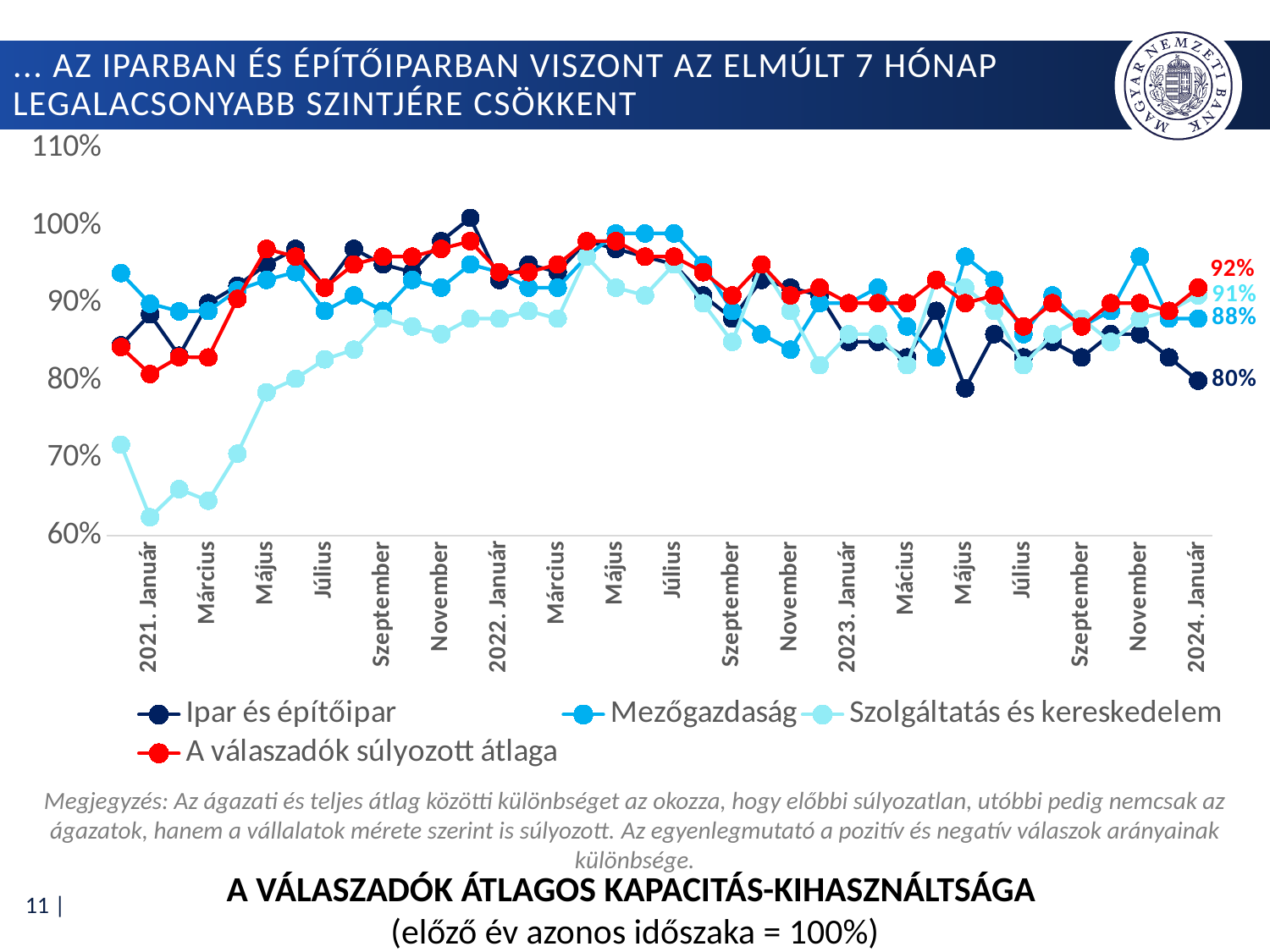
Is the value for Szolgáltatás és kereskedelem in 2021. Január greater or less than 80%? less What is the difference between A válaszadók súlyozott átlaga and Ipar és építőipar in 2024. Január? 12 percentage points Which series has the lowest value in 2024. Január? Ipar és építőipar In 2024. Január, which is larger: Mezőgazdaság or Ipar és építőipar? Mezőgazdaság What is the value for Ipar és építőipar in 2024. Január? 80% How many series does the legend list? 4 What kind of chart is shown on the slide? line chart What is the value for Mezőgazdaság in 2024. Január? 88% What is the value for Szolgáltatás és kereskedelem in 2024. Január? 91% What is the value for A válaszadók súlyozott átlaga in 2024. Január? 92% Which series has the highest value in 2024. Január? A válaszadók súlyozott átlaga What is the title of the chart? A válaszadók átlagos kapacitás-kihasználtsága (előző év azonos időszaka = 100%)